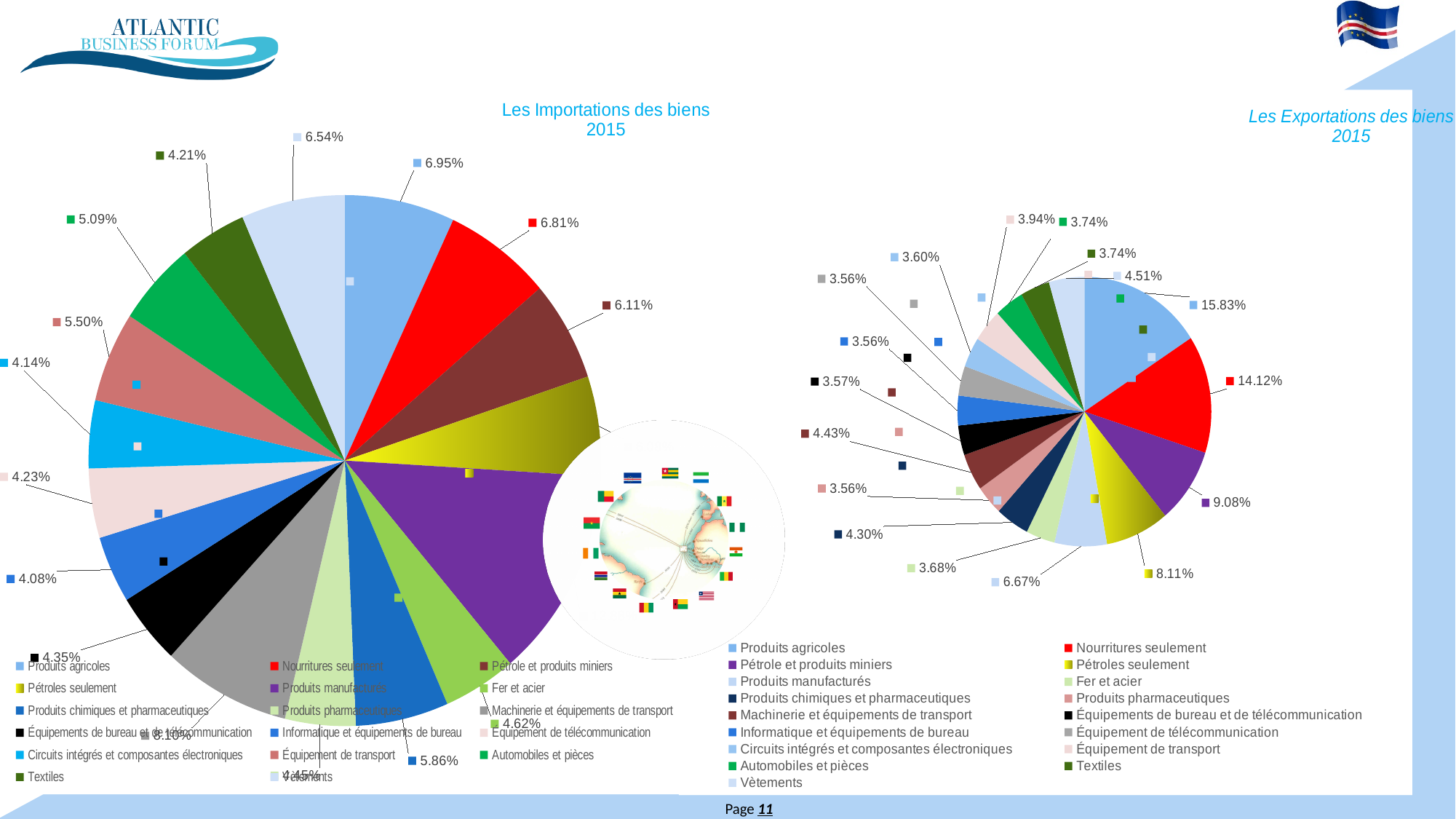
In the "Les Importations des biens 2015" chart, what is the share for Vêtements? 6.54% In the "Les Exportations des biens 2015" chart, which category has the largest share? Produits agricoles In the "Les Exportations des biens 2015" chart, what is the share for Nourritures seulement? 14.12% In the "Les Importations des biens 2015" chart, what is the share for Textiles? 4.21% In the "Les Exportations des biens 2015" chart, what is the difference between Pétrole et produits miniers and Pétroles seulement? 0.97% In the "Les Importations des biens 2015" chart, what is the share for Machinerie et équipements de transport? 8.10% In the "Les Importations des biens 2015" chart, which is larger: Produits agricoles or Nourritures seulement? Produits agricoles In the "Les Exportations des biens 2015" chart, what is the difference between the shares of Produits agricoles and Nourritures seulement? 1.71% In the "Les Exportations des biens 2015" chart, what is the share for Pétroles seulement? 8.11% What kind of chart is "Les Importations des biens 2015"? Pie chart How many categories does the legend of the "Les Exportations des biens 2015" chart list? 17 In the "Les Exportations des biens 2015" chart, what is the share for Produits agricoles? 15.83%